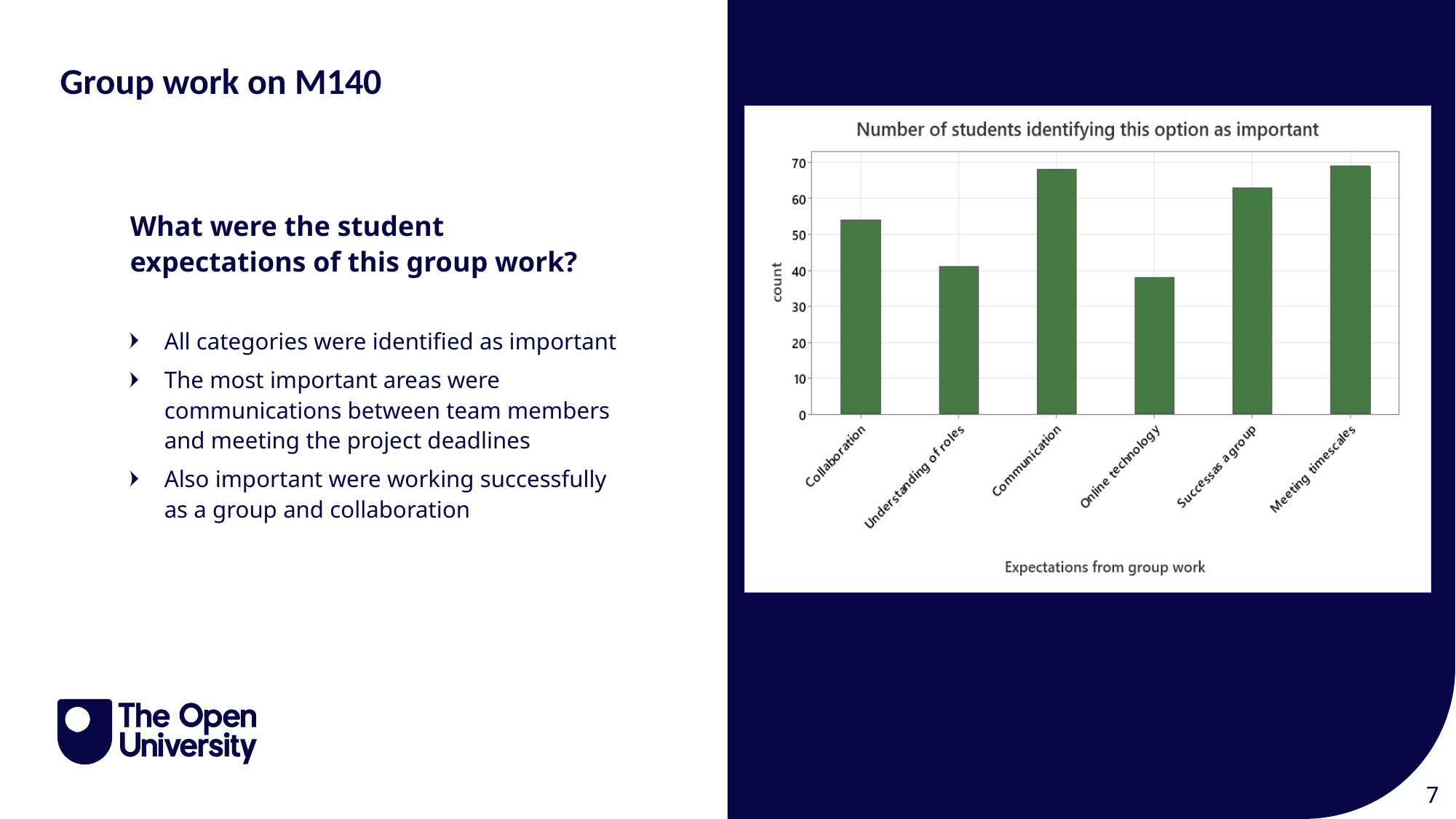
Is the value for Communication greater or less than 60? greater Which has a lower value, Collaboration or Understanding of roles? Understanding of roles Which has a higher value, Online technology or Success as a group? Success as a group What is the title of the chart? Number of students identifying this option as important Is the value for Understanding of roles greater or less than 50? less How many categories are shown on the x axis of the chart? 6 Which has a higher value, Collaboration or Communication? Communication What is the label of the x axis of the chart? Expectations from group work Is the value for Online technology greater or less than 40? less What kind of chart is shown on the slide? bar chart